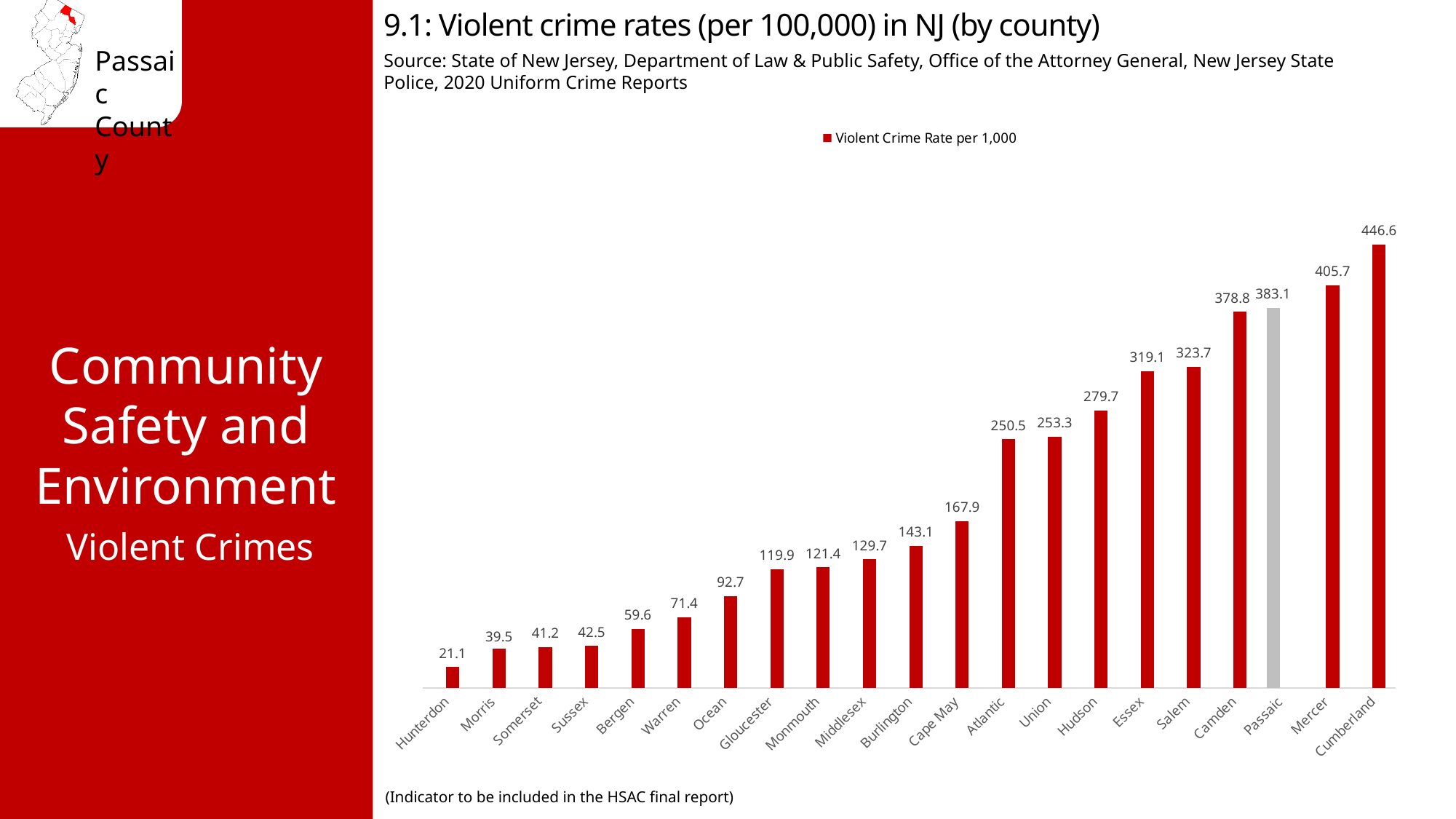
Which county has the lowest violent crime rate on the chart? Hunterdon Which county's bar is shown in grey rather than red? Passaic What is the difference between the violent crime rates of Mercer and Passaic? 22.6 What is the violent crime rate shown for Bergen? 59.6 Which has a higher violent crime rate, Essex or Atlantic? Essex Which county has the highest violent crime rate on the chart? Cumberland What is the difference between the violent crime rates of Cumberland and Hunterdon? 425.5 How many series does the legend list? 1 What kind of chart is shown on the slide? Bar chart How many counties are shown on the chart? 21 What is the violent crime rate shown for Passaic? 383.1 What is the violent crime rate shown for Hudson? 279.7